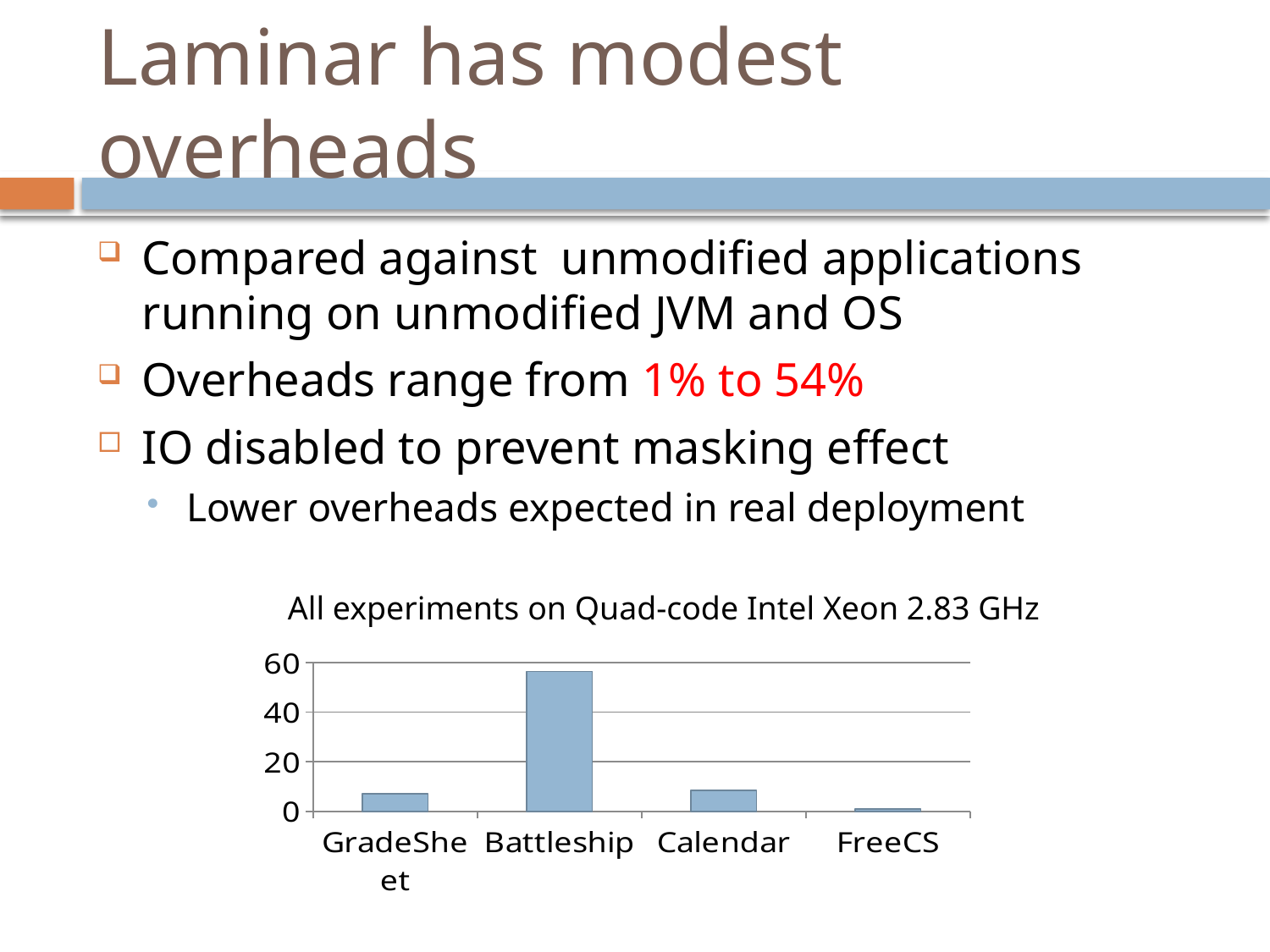
How many categories are plotted on the x axis of the chart? 4 Which is larger, the value for GradeSheet or the value for FreeCS? GradeSheet Is the value for Battleship greater or less than 40? greater Is the value for GradeSheet greater or less than 20? less Is the value for FreeCS greater or less than 20? less Which category has the lowest bar in the chart? FreeCS What text appears directly above the chart describing the experimental setup? All experiments on Quad-code Intel Xeon 2.83 GHz What kind of chart is shown on the slide? bar chart Which category has the highest bar in the chart? Battleship Which is larger, the value for Battleship or the value for Calendar? Battleship What is the highest tick value shown on the y axis of the chart? 60